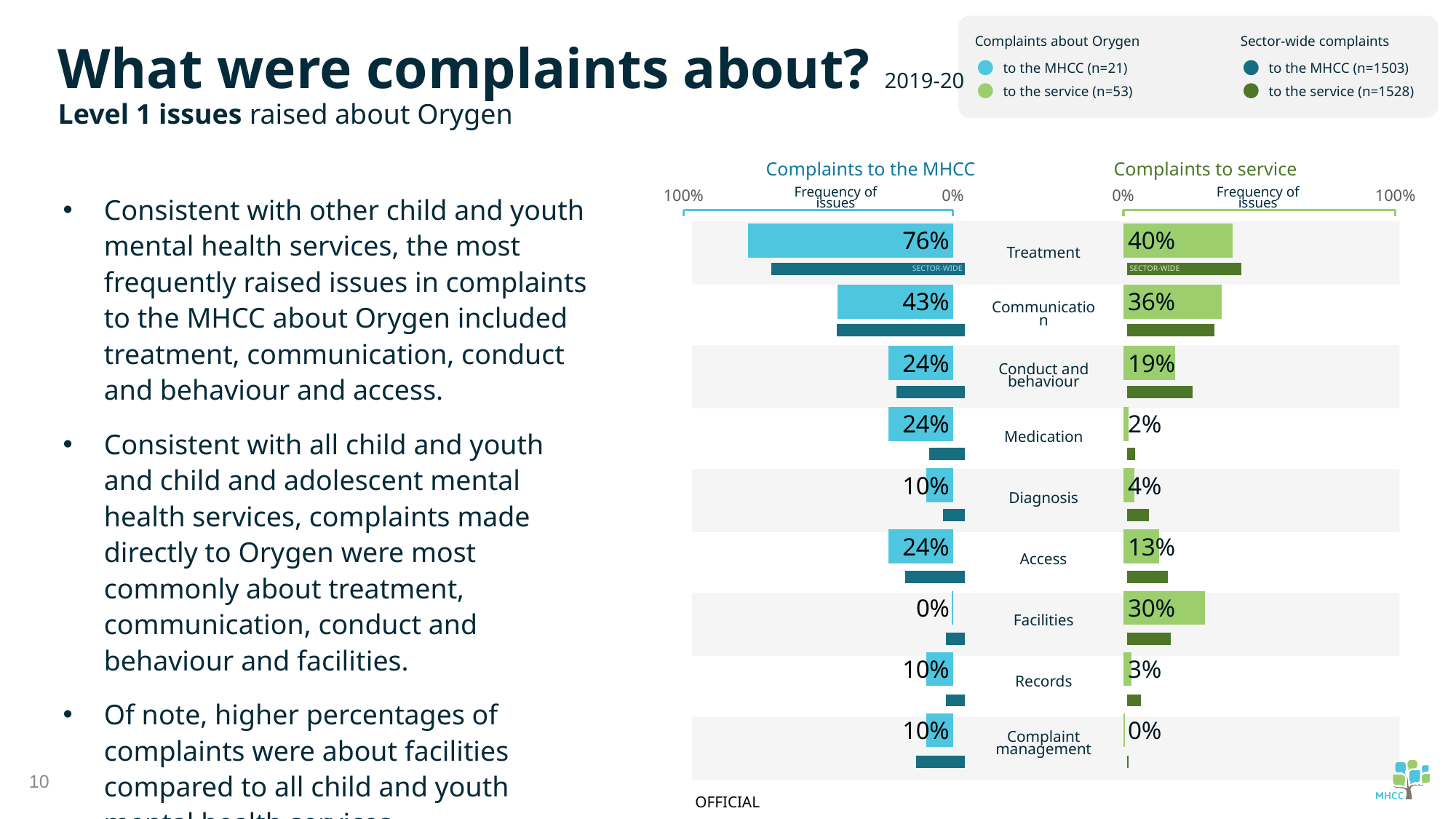
In the 'Complaints to service' chart, what percentage of complaints about Orygen were about Communication? 36% For Orygen complaints about Facilities, which is larger: the percentage of complaints to the MHCC or the percentage of complaints to the service? Complaints to service In the 'Complaints to service' chart, which issue has the lowest percentage for complaints about Orygen? Complaint management What type of chart is used to show the frequency of issues? Bar chart In the 'Complaints to the MHCC' chart, what is the difference between the Orygen percentages for Treatment and Communication? 33% In the 'Complaints to the MHCC' chart, which issue has the highest percentage for complaints about Orygen? Treatment How many issue categories are shown in the chart? 9 In the 'Complaints to service' chart, what percentage of complaints about Orygen were about Facilities? 30% In the 'Complaints to the MHCC' chart, which issue has the lowest percentage for complaints about Orygen? Facilities For Orygen complaints about Medication, which is larger: the percentage of complaints to the MHCC or the percentage of complaints to the service? Complaints to the MHCC How many series does the legend at the top of the slide list? 4 In the 'Complaints to the MHCC' chart, what percentage of complaints about Orygen were about Treatment? 76%